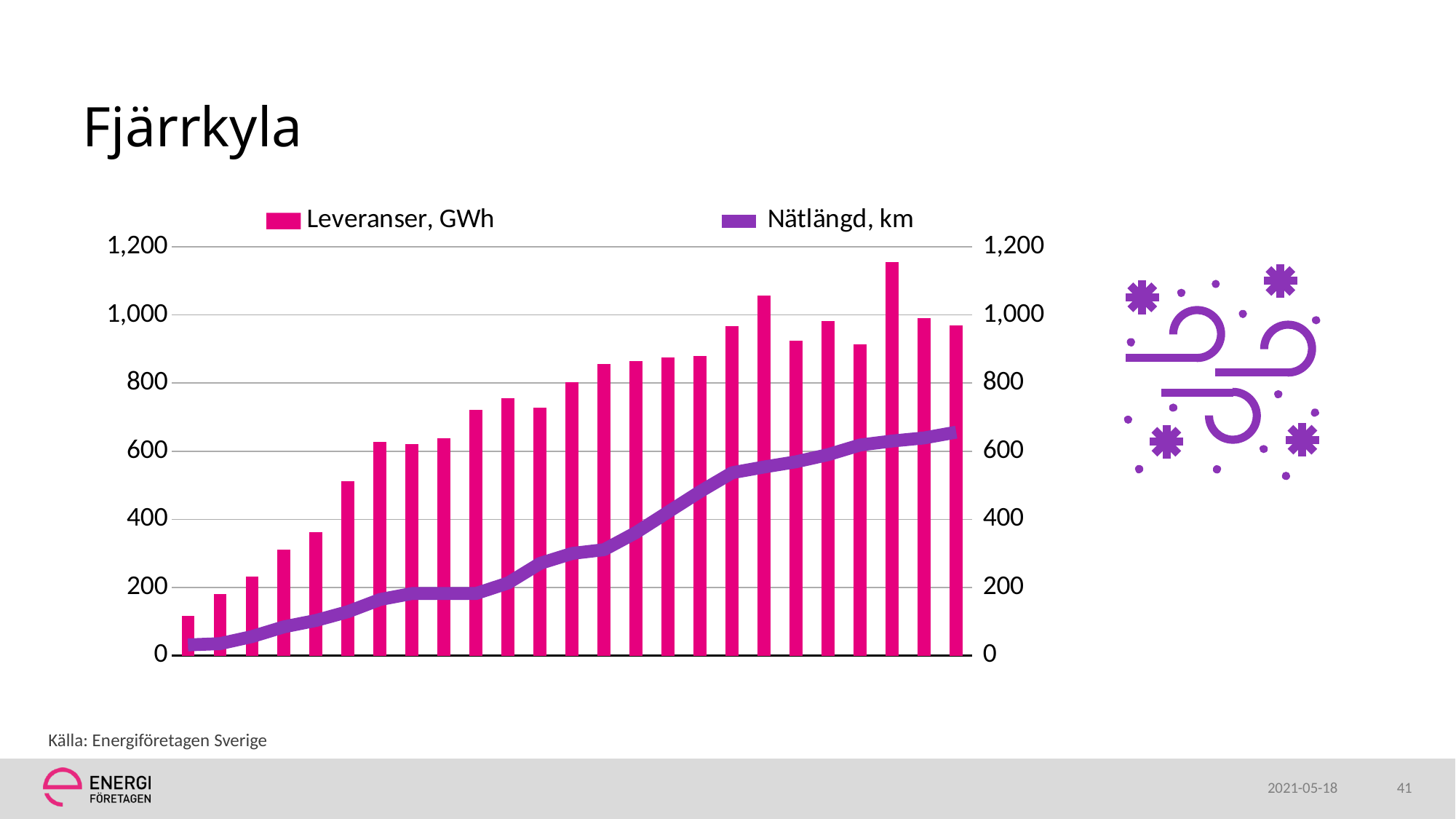
What kind of chart is shown on the slide? A combined bar and line chart Does the Nätlängd, km line rise or fall from left to right? Rise Is the final value of the Nätlängd, km line greater or less than 600? greater Is the leftmost Leveranser, GWh bar greater or less than 200? less What are the two series named in the chart legend? Leveranser, GWh and Nätlängd, km Do the Leveranser, GWh bars generally rise or fall from left to right? Rise Which bar is the shortest for Leveranser, GWh? The leftmost bar Which series is drawn as a purple line? Nätlängd, km How many series does the chart legend list? 2 Is the tallest Leveranser, GWh bar greater or less than 1,000? greater How many bars are plotted for Leveranser, GWh? 25 Which bar is the tallest for Leveranser, GWh? The third bar from the right